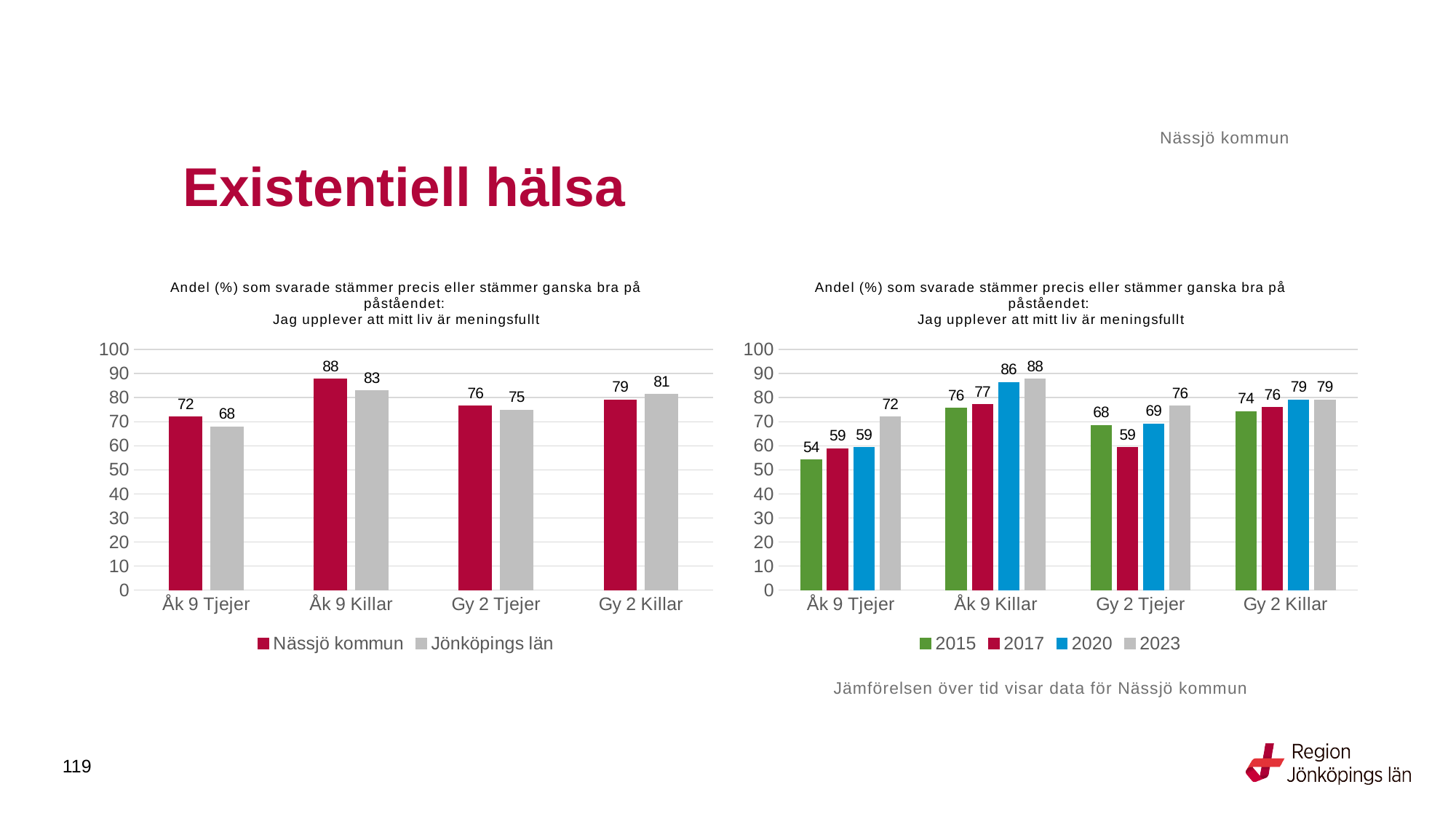
In the right chart, what is the difference between 2023 and 2015 for Åk 9 Tjejer? 18 In the right chart, what is the value for 2015 for Åk 9 Tjejer? 54 In the left chart, how many series does the legend list? 2 In the right chart, what is the value for 2020 for Åk 9 Killar? 86 In the left chart, which is larger for Gy 2 Killar: Nässjö kommun or Jönköpings län? Jönköpings län In the right chart, which category has the highest value for 2023? Åk 9 Killar In the right chart, how many series does the legend list? 4 In the left chart, which category has the lowest value for Jönköpings län? Åk 9 Tjejer In the left chart, what is the value for Nässjö kommun for Åk 9 Killar? 88 In the left chart, what is the value for Jönköpings län for Gy 2 Tjejer? 75 What type of chart is the right chart? Bar chart In the left chart, what is the difference between Nässjö kommun and Jönköpings län for Åk 9 Killar? 5